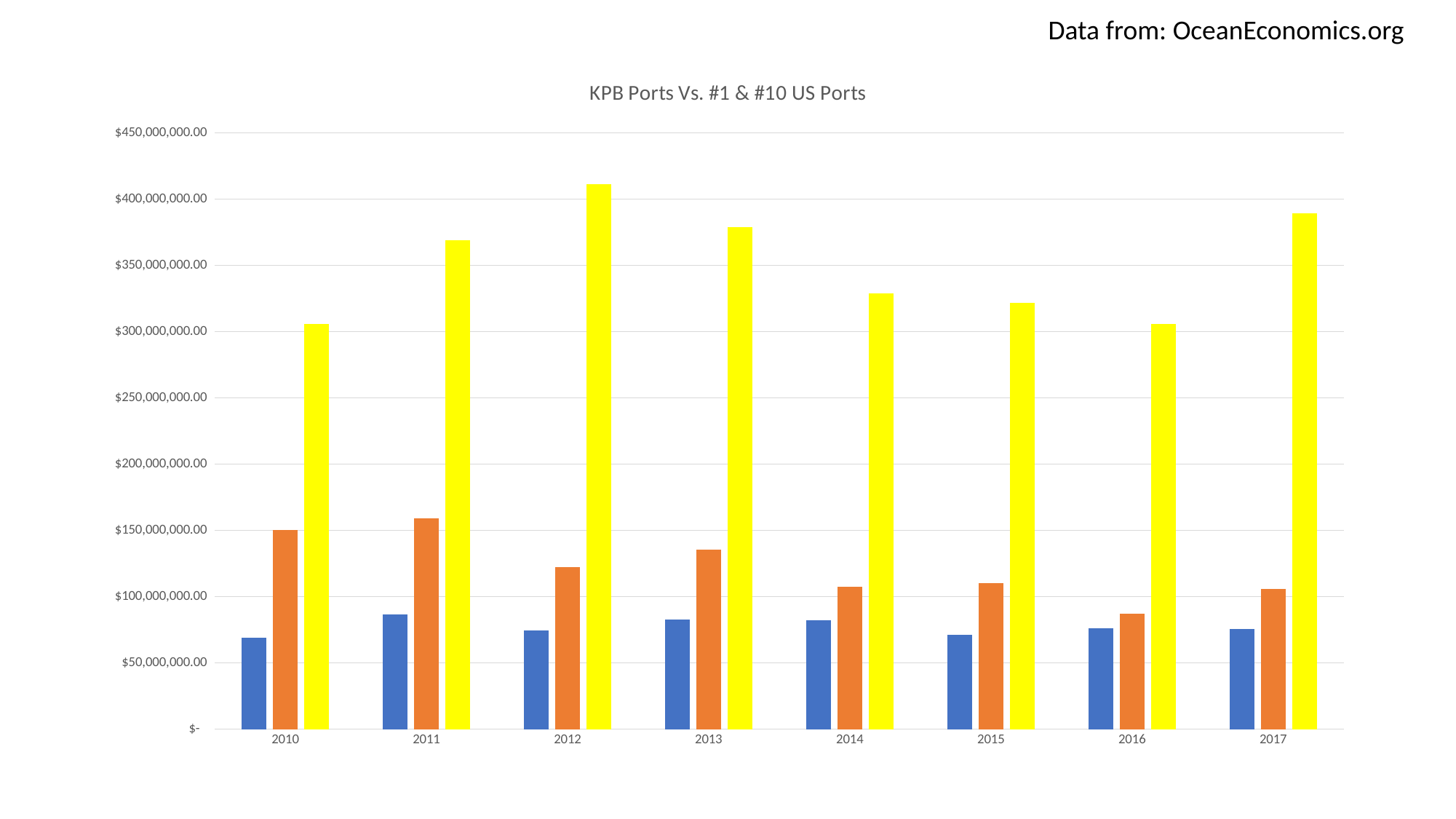
Is the value of the blue bar for 2011 greater or less than $100,000,000.00? less How many years are shown on the x axis of the chart? 8 Which is larger: the orange bar for 2011 or the orange bar for 2012? 2011 Is the value of the yellow bar for 2012 greater or less than $400,000,000.00? greater Is the value of the yellow bar for 2014 greater or less than $350,000,000.00? less In which year is the orange bar the tallest? 2011 In which year is the yellow bar the tallest? 2012 How many bars are plotted for each year in the chart? 3 What is the title of the chart? KPB Ports Vs. #1 & #10 US Ports Which is larger: the yellow bar for 2013 or the yellow bar for 2014? 2013 What kind of chart is shown on the slide? bar chart